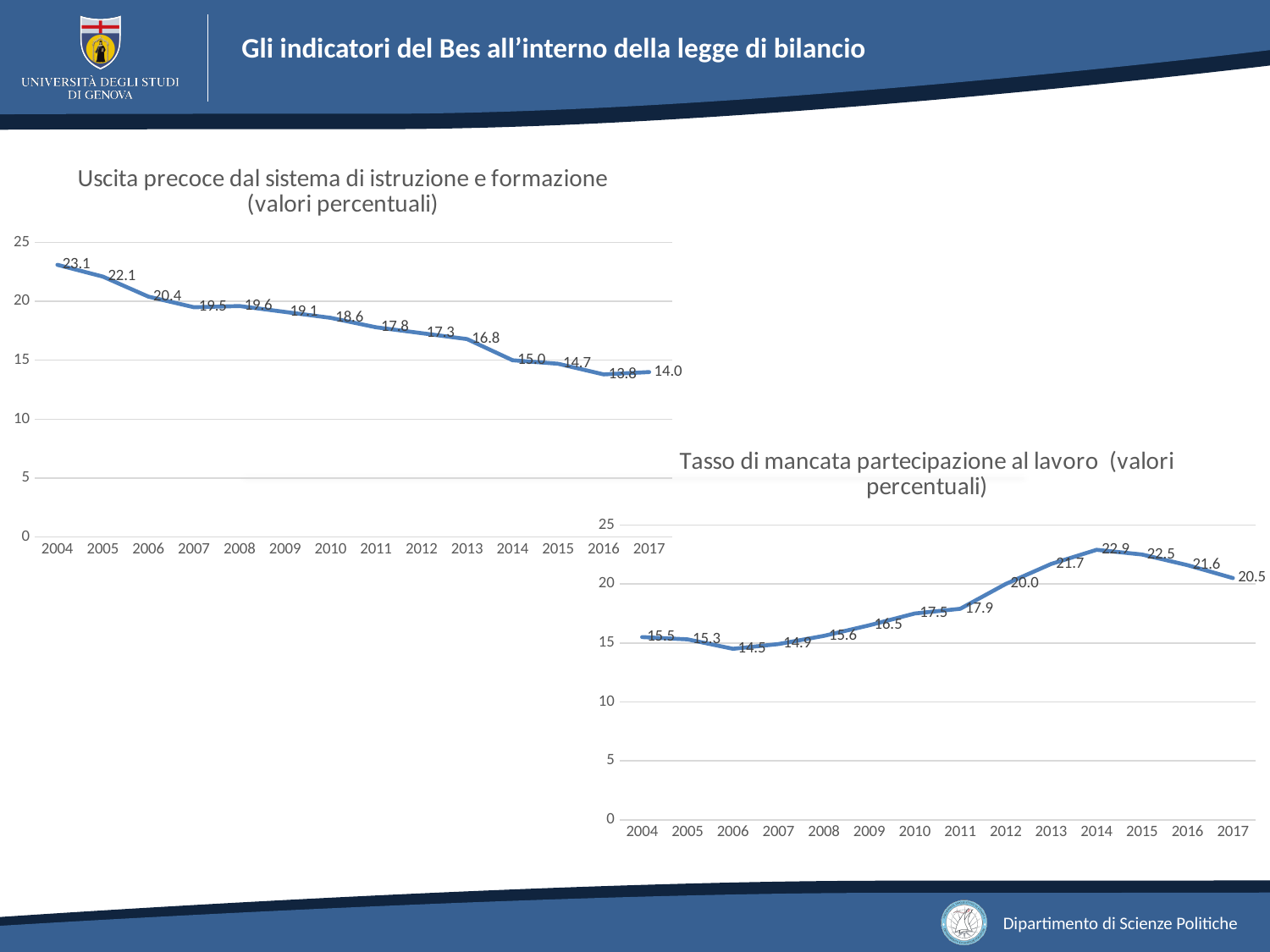
In the chart 'Uscita precoce dal sistema di istruzione e formazione', what is the value for 2004? 23.1 In the chart 'Tasso di mancata partecipazione al lavoro', what is the value for 2014? 22.9 In the chart 'Uscita precoce dal sistema di istruzione e formazione', which year has the lowest value? 2016 How many years are plotted in the chart 'Tasso di mancata partecipazione al lavoro'? 14 In the chart 'Uscita precoce dal sistema di istruzione e formazione', do the values generally rise or fall from 2004 to 2017? fall In the chart 'Tasso di mancata partecipazione al lavoro', what is the difference between the 2014 and 2004 values? 7.4 In the chart 'Uscita precoce dal sistema di istruzione e formazione', what is the difference between the 2004 and 2017 values? 9.1 In the chart 'Tasso di mancata partecipazione al lavoro', which year has the highest value? 2014 In the chart 'Tasso di mancata partecipazione al lavoro', is the value for 2012 larger than the value for 2011? Yes In the chart 'Uscita precoce dal sistema di istruzione e formazione', what is the value for 2017? 14.0 What kind of chart is 'Uscita precoce dal sistema di istruzione e formazione'? Line chart In the chart 'Tasso di mancata partecipazione al lavoro', which year has the lowest value? 2006